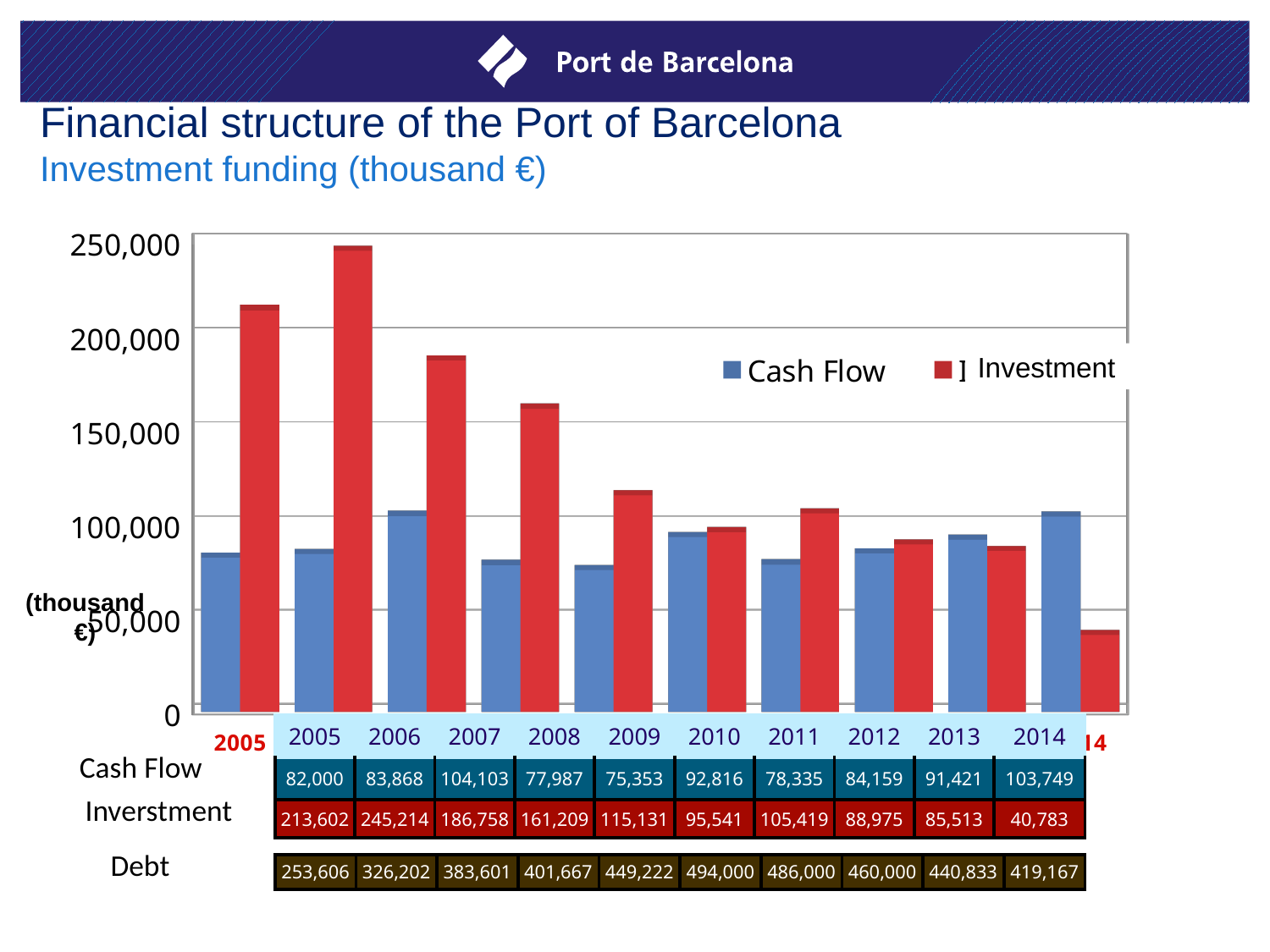
In which year is Investment highest? 2006 In which year is Cash Flow lowest? 2009 Which is larger in 2014, Cash Flow or Investment? Cash Flow How many years are shown on the x axis of the chart? 10 What is the Investment value for 2009? 115,131 What is the Investment value for 2014? 40,783 How many series does the chart legend list? 2 What is the Cash Flow value for 2007? 104,103 Is the Investment value for 2006 greater or less than 200,000? greater What is the difference between Investment and Cash Flow in 2005? 131,602 What kind of chart is shown on the slide? Bar chart In which year is Investment lowest? 2014